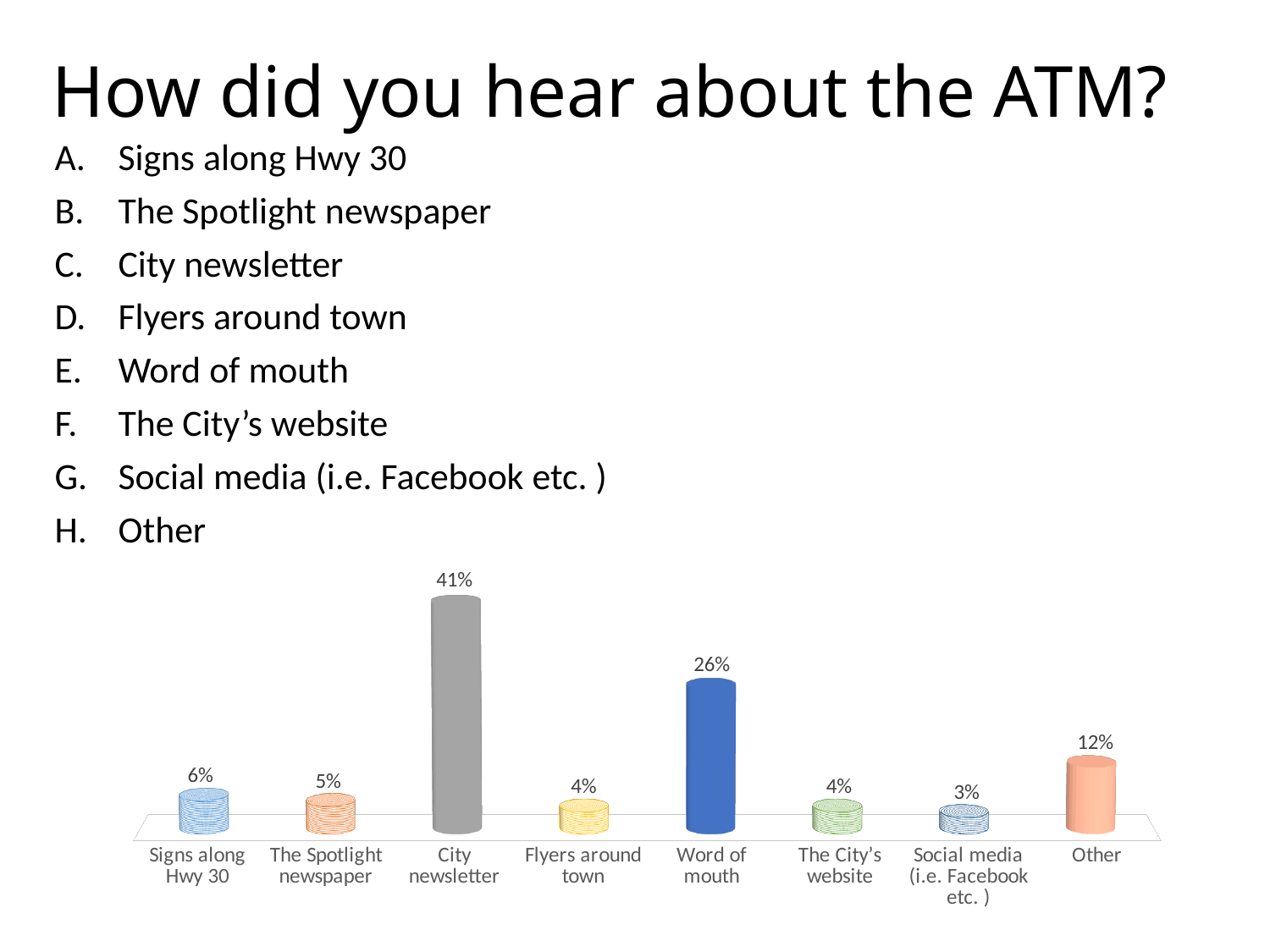
Which is larger, the value for Other or the value for The Spotlight newspaper? Other Which category has the lowest value? Social media (i.e. Facebook etc. ) What is the difference between the values for Signs along Hwy 30 and Social media (i.e. Facebook etc. )? 3% What is the difference between the City newsletter value and the Word of mouth value? 15% What percentage is shown for Other? 12% What is the value for Signs along Hwy 30? 6% What is the title of the slide containing the chart? How did you hear about the ATM? How many categories are shown on the chart? 8 What percentage of respondents heard about the ATM from the City newsletter? 41% What is the value shown for Word of mouth? 26% What kind of chart is shown on the slide? Bar chart Which category has the highest value? City newsletter